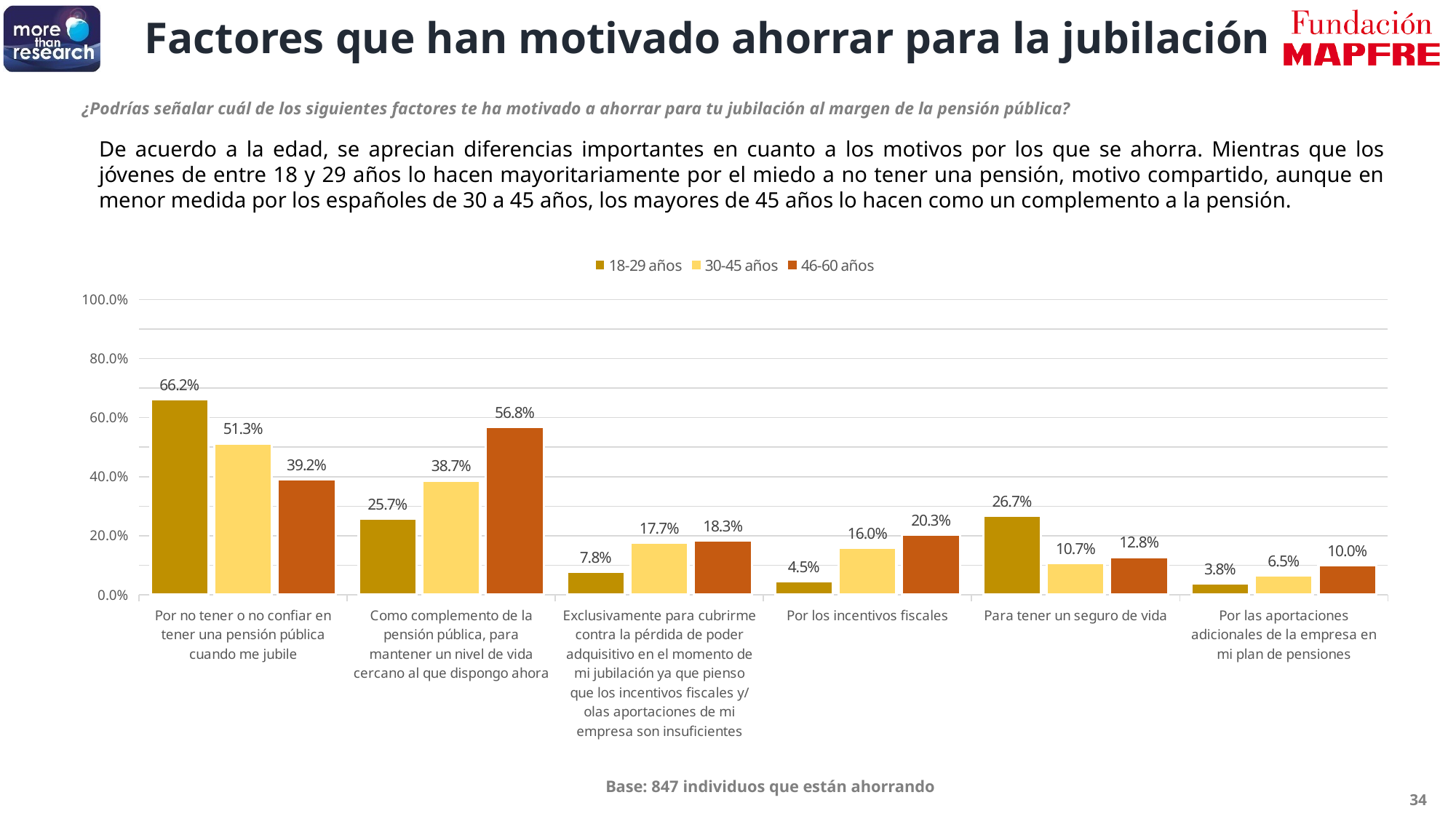
Which category has the lowest value for the 46-60 años series? Por las aportaciones adicionales de la empresa en mi plan de pensiones What is the difference between the 18-29 años and 46-60 años values in the category "Por no tener o no confiar en tener una pensión pública cuando me jubile"? 27.0% In the category "Para tener un seguro de vida", which series has the larger value: 18-29 años or 46-60 años? 18-29 años What is the value for the 46-60 años series in the category "Como complemento de la pensión pública, para mantener un nivel de vida cercano al que dispongo ahora"? 56.8% What is the value for the 30-45 años series in the category "Por los incentivos fiscales"? 16.0% Is the value for the 30-45 años series in the category "Como complemento de la pensión pública, para mantener un nivel de vida cercano al que dispongo ahora" greater or less than 40.0%? less What kind of chart is shown on the slide? Bar chart How many categories are shown on the x axis of the chart? 6 How many series does the legend list? 3 Which category has the highest value for the 18-29 años series? Por no tener o no confiar en tener una pensión pública cuando me jubile What is the base (number of individuals) stated below the chart? 847 individuos que están ahorrando What is the value for the 18-29 años series in the category "Por no tener o no confiar en tener una pensión pública cuando me jubile"? 66.2%